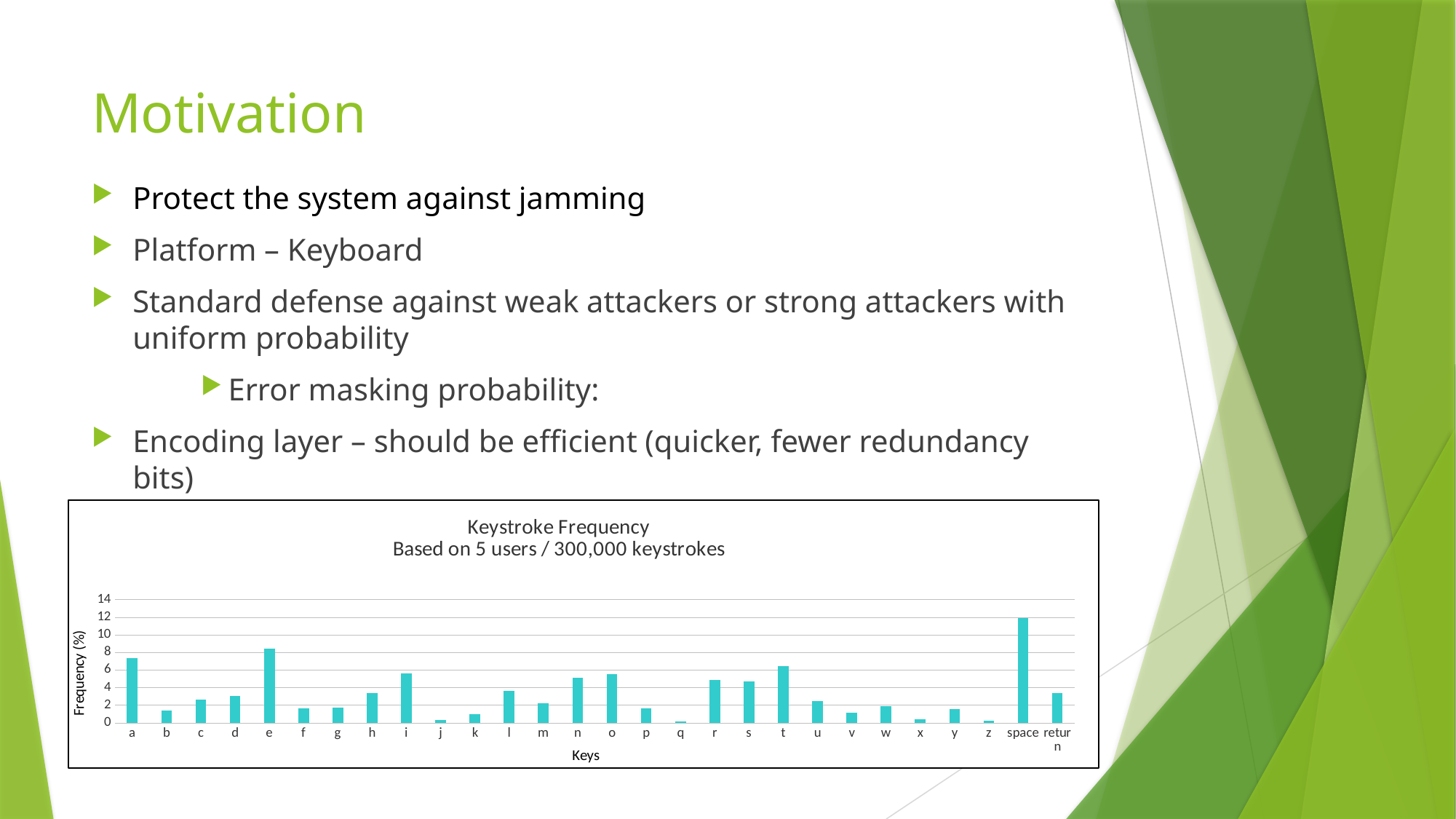
Is the frequency for the key e greater or less than 6? greater Is the frequency for the key t greater or less than 4? greater What kind of chart is shown on the slide? bar chart Which key has the highest frequency in the chart? space Is the frequency for the key a greater or less than 6? greater Which key has the higher frequency, e or a? e What is the title of the chart? Keystroke Frequency Based on 5 users / 300,000 keystrokes Which key has the higher frequency, space or e? space What is the label of the vertical axis of the chart? Frequency (%) How many keys (categories) are plotted on the x axis of the chart? 28